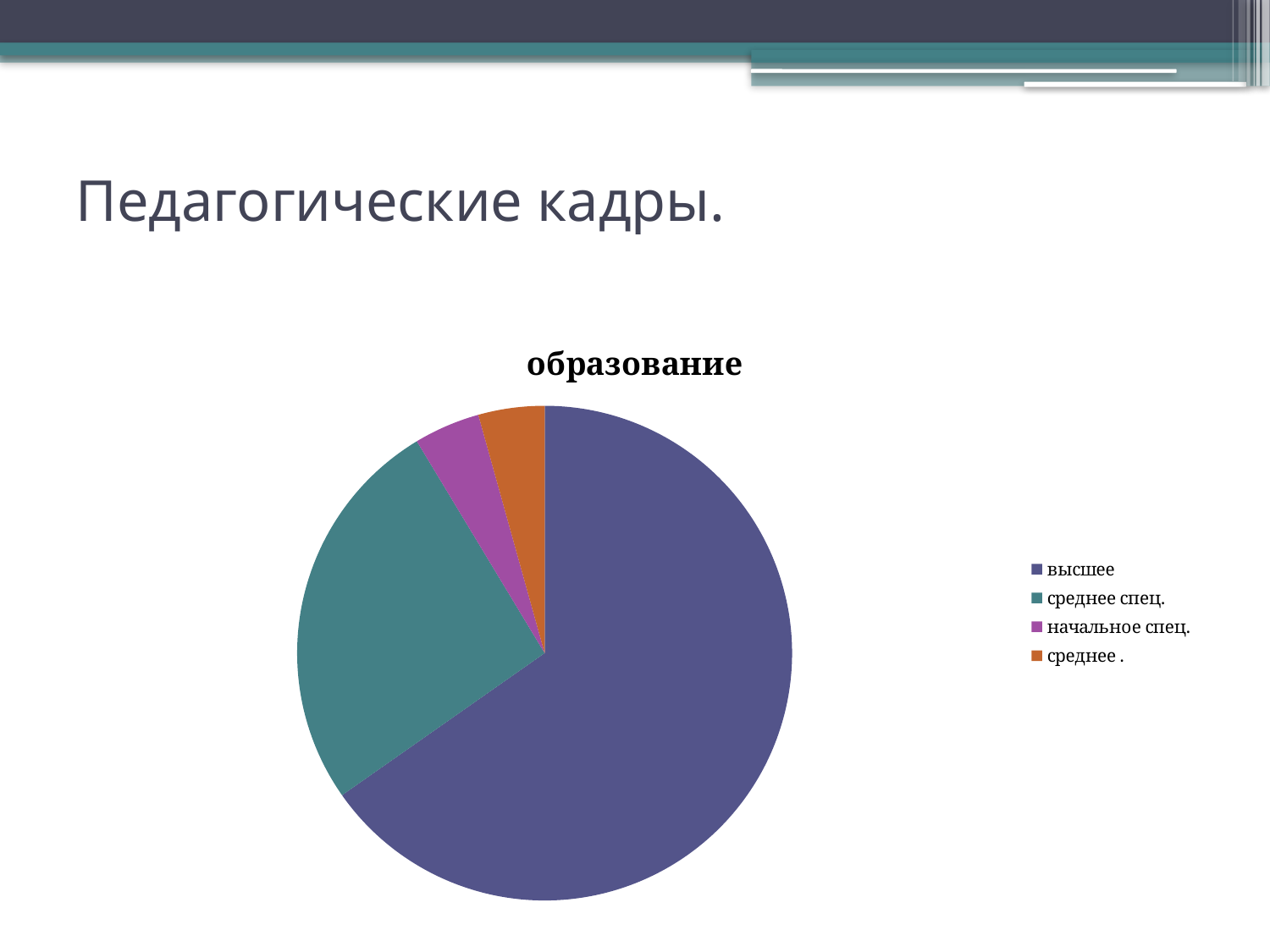
Which category is shown in orange in the legend? среднее . How many categories does the pie chart have? 4 Does the slice for высшее take up more or less than half of the pie? more Which slice is larger: среднее спец. or среднее .? среднее спец. What kind of chart is shown on the slide? pie chart What is the title of the chart? образование Which slice is larger: среднее спец. or начальное спец.? среднее спец. Which slice is larger: высшее or среднее спец.? высшее Which category has the largest slice of the pie? высшее